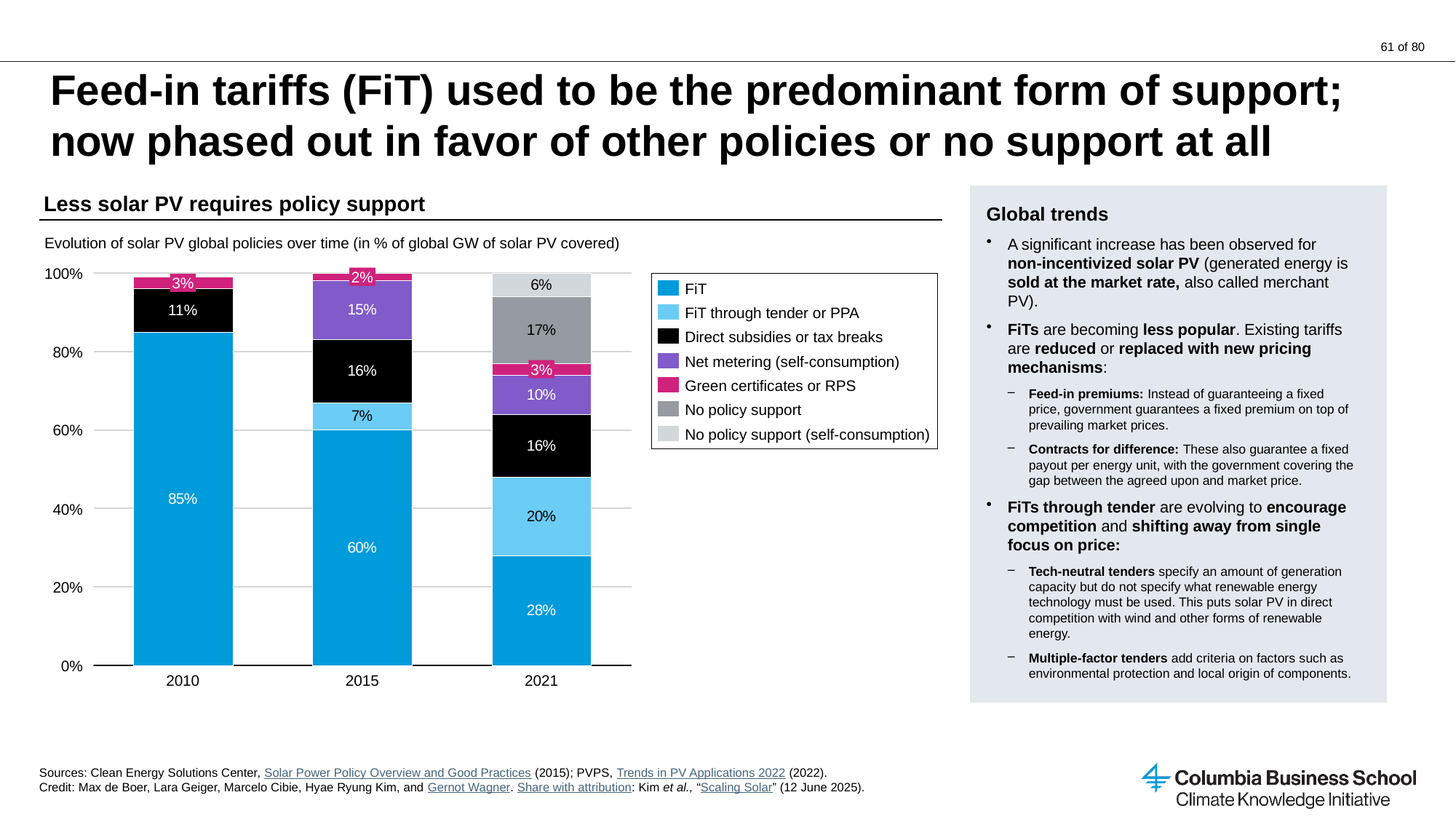
What is the FiT share in 2010? 85% How many series does the legend list? 7 How many years are shown on the x axis? 3 In which year is the FiT share the highest? 2010 Which is larger in 2021: the FiT share or the FiT through tender or PPA share? FiT Does the FiT share rise or fall from 2010 to 2021? Fall What kind of chart is shown? Stacked bar chart By how many percentage points did the FiT share fall from 2010 to 2021? 57 percentage points In which year is the FiT share the lowest? 2021 What is the share of No policy support in 2021? 17% What is the share of FiT through tender or PPA in 2021? 20% What is the share of Net metering (self-consumption) in 2015? 15%